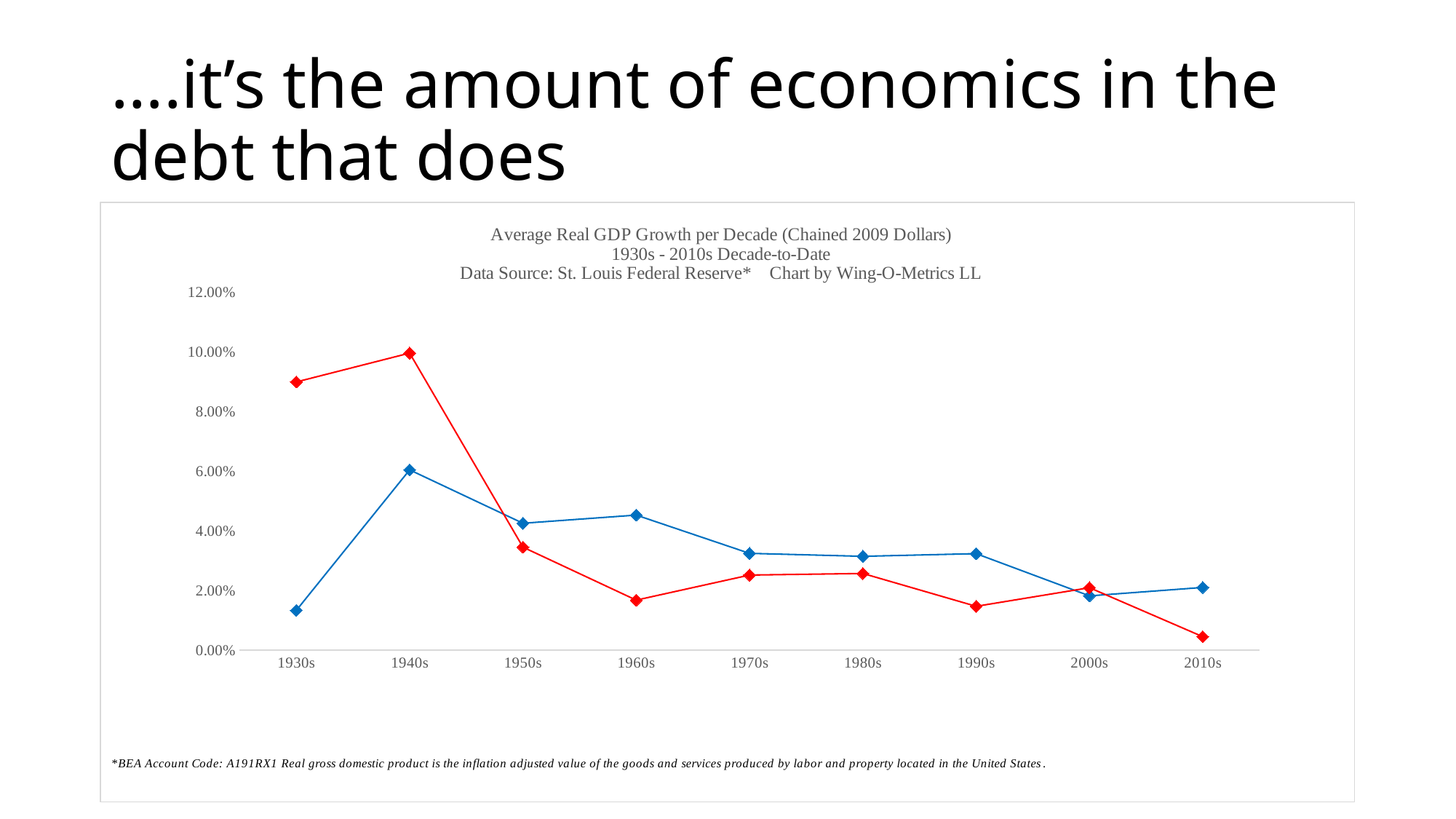
In which decade does the blue line reach its highest value? 1940s Does the red line rise or fall from the 1940s to the 1960s? fall In which decade does the blue line reach its lowest value? 1930s In which decade does the red line reach its highest value? 1940s In the 1930s, which line has the higher value, the red line or the blue line? red line What kind of chart is shown on the slide? line chart How many decades are plotted along the x axis? 9 In which decade does the red line reach its lowest value? 2010s Is the red line's value for the 1930s greater or less than 8.00%? greater Is the red line's value for the 2010s greater or less than 2.00%? less In the 1960s, which line has the higher value, the red line or the blue line? blue line Is the blue line's value for the 1940s greater or less than 8.00%? less